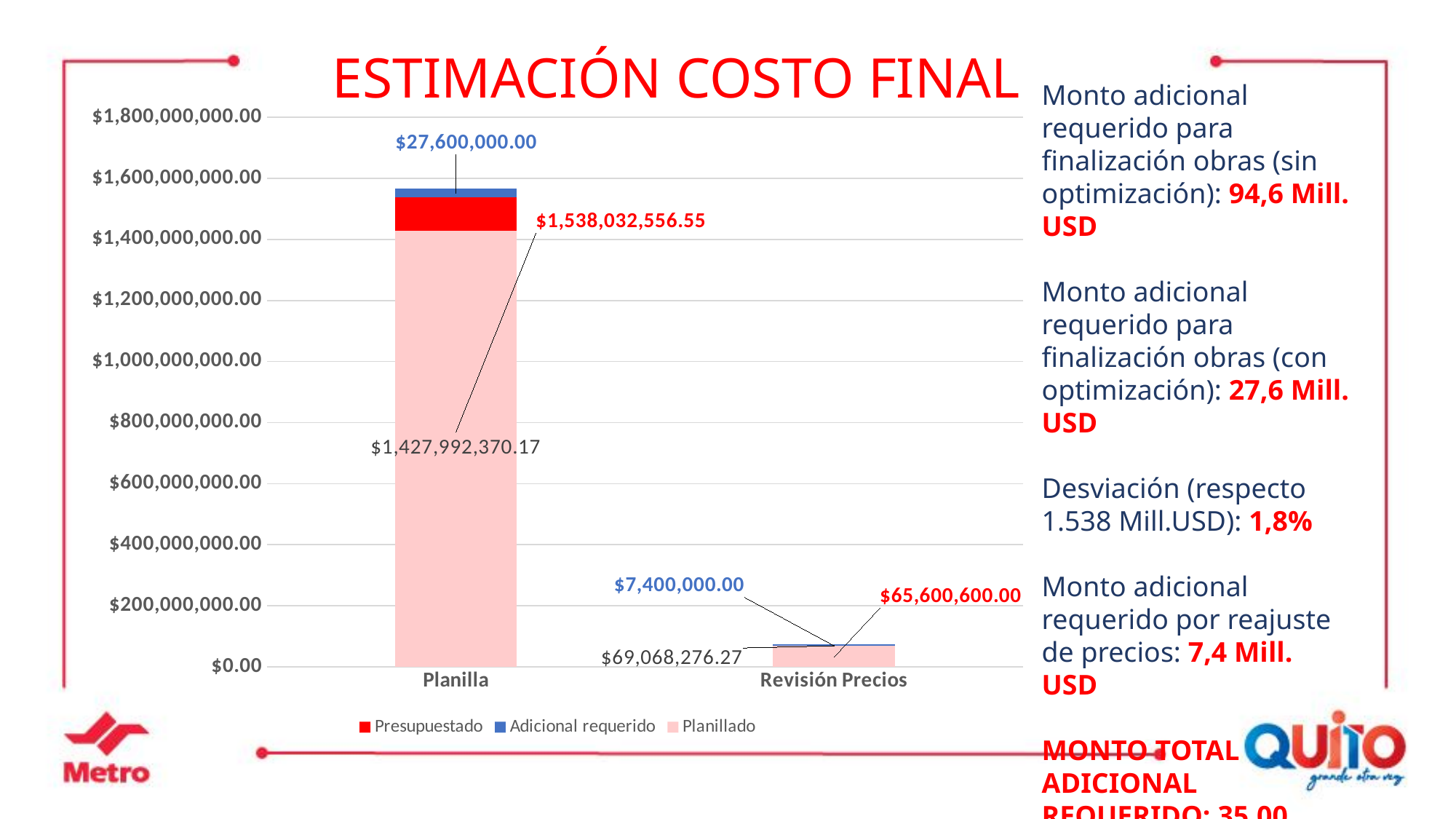
Which category has the higher Adicional requerido value, Planilla or Revisión Precios? Planilla What is the Adicional requerido value for Planilla? $27,600,000.00 What is the Planillado value for Revisión Precios? $69,068,276.27 What is the Adicional requerido value for Revisión Precios? $7,400,000.00 What is the Presupuestado value labelled for Planilla? $1,538,032,556.55 What is the difference between the Adicional requerido values for Planilla and Revisión Precios? $20,200,000.00 How many categories are shown on the x axis? 2 How many series does the legend list? 3 Is the Planillado value for Planilla greater or less than $1,400,000,000.00? greater What is the Presupuestado value labelled for Revisión Precios? $65,600,600.00 What type of chart is shown on the slide? bar chart What is the Planillado value for Planilla? $1,427,992,370.17